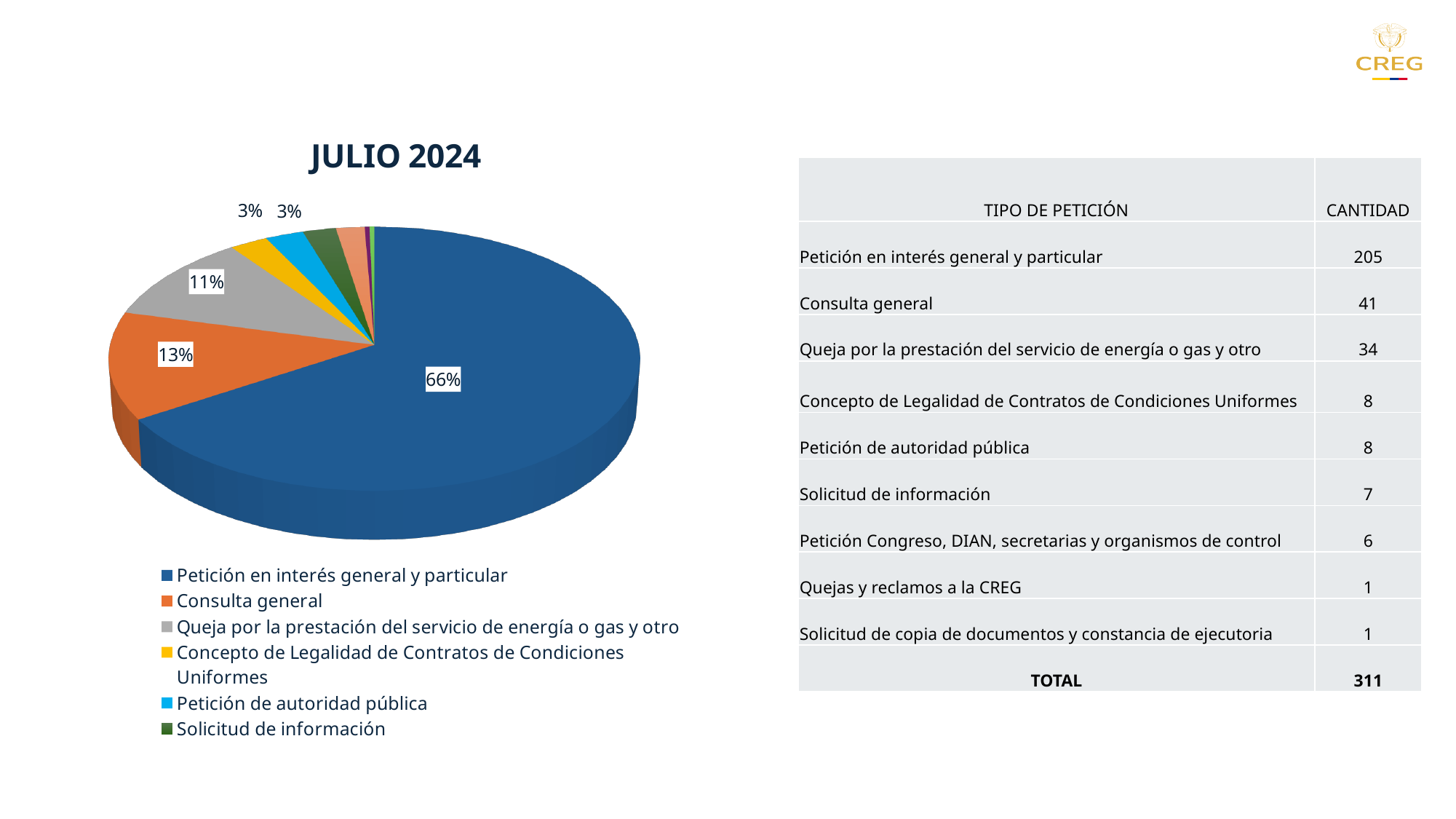
What kind of chart is shown on the slide? Pie chart What percentage is shown for "Concepto de Legalidad de Contratos de Condiciones Uniformes" in the pie chart? 3% What colour represents "Consulta general" in the pie chart? Orange What percentage of the pie does "Petición en interés general y particular" represent? 66% By how many percentage points does the "Petición en interés general y particular" slice exceed the "Consulta general" slice? 53 percentage points What percentage is shown for "Consulta general" in the pie chart? 13% How many entries does the legend of the pie chart list? 6 Which slice is larger in the pie chart: "Consulta general" or "Queja por la prestación del servicio de energía o gas y otro"? Consulta general What percentage is shown for "Queja por la prestación del servicio de energía o gas y otro" in the pie chart? 11% What is the title of the pie chart? JULIO 2024 Which category has the largest slice in the pie chart? Petición en interés general y particular